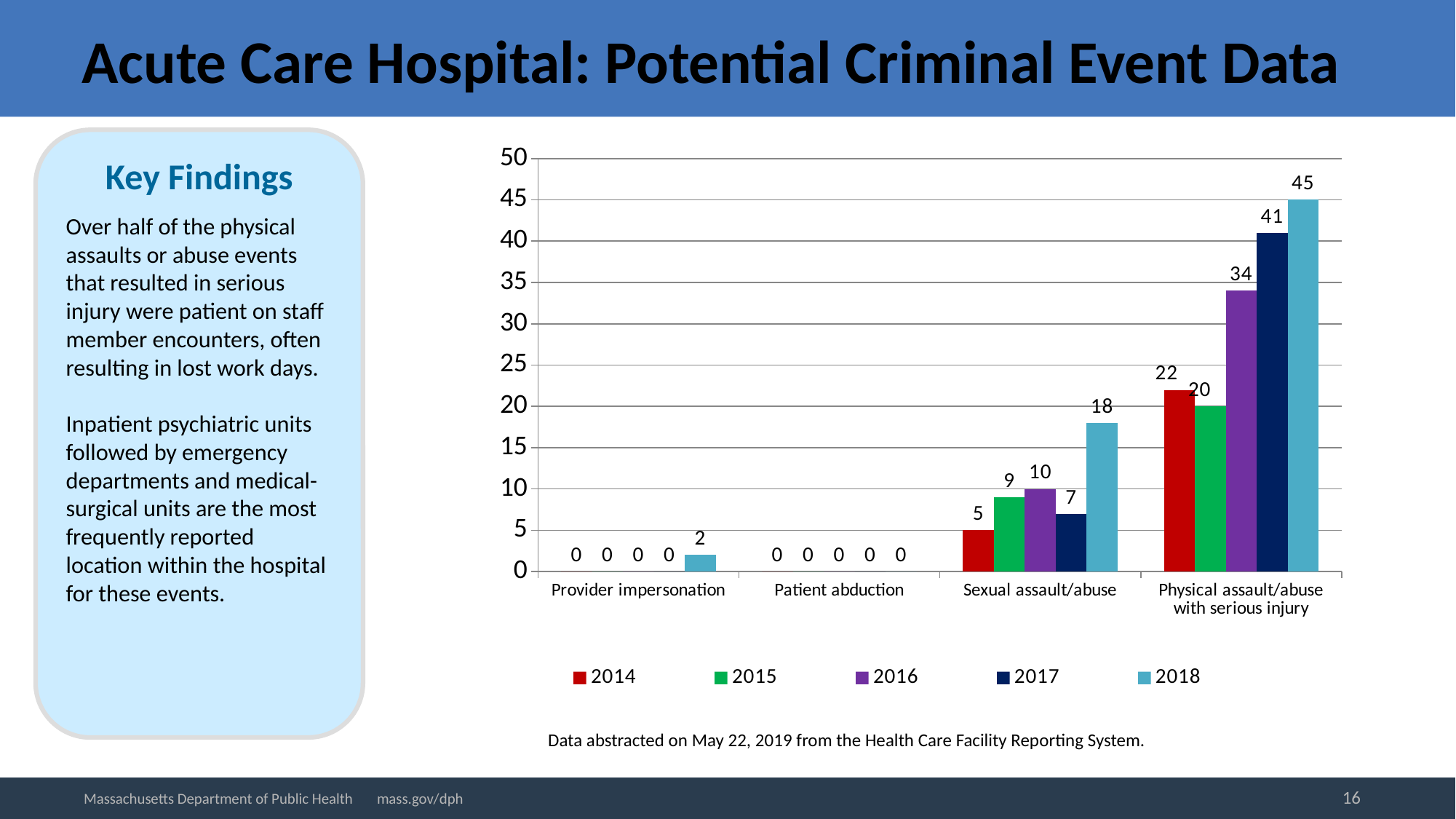
What kind of chart is shown on the slide? Bar chart How many categories are shown on the x axis? 4 Which is larger in the Sexual assault/abuse category: the 2016 value or the 2017 value? 2016 Which year has the highest value in the Physical assault/abuse with serious injury category? 2018 How many series does the legend list? 5 Do the values for Physical assault/abuse with serious injury rise or fall from 2015 to 2018? Rise What is the value for 2014 in the Sexual assault/abuse category? 5 What is the value for 2018 in the Physical assault/abuse with serious injury category? 45 What is the value for every year in the Patient abduction category? 0 Which year has the lowest value in the Sexual assault/abuse category? 2014 What is the difference between the 2018 and 2017 values in the Physical assault/abuse with serious injury category? 4 What is the value for 2018 in the Provider impersonation category? 2